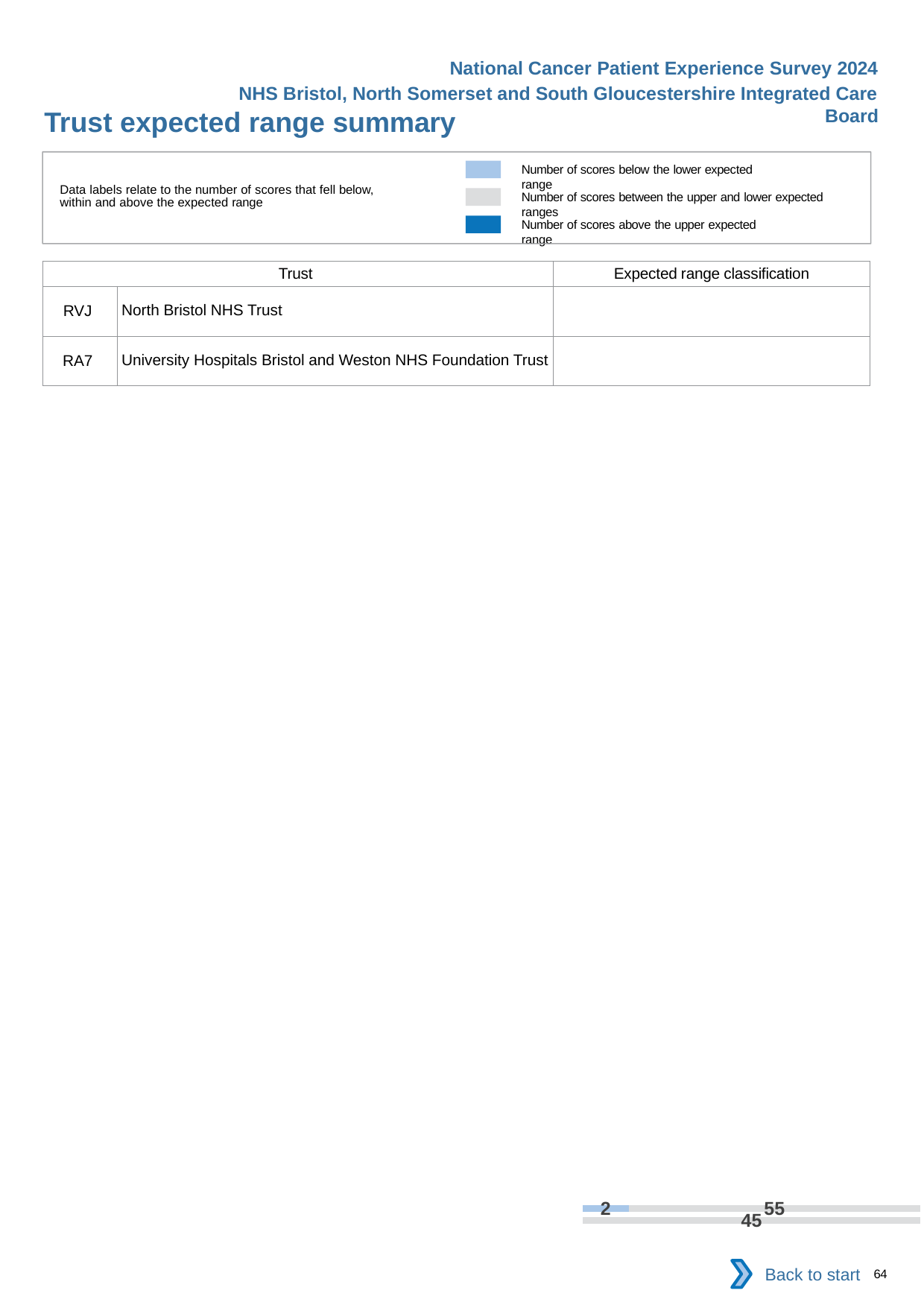
Which is larger: the grey segment of the upper bar or the grey segment of the lower bar? the grey segment of the upper bar What is the data label on the light blue segment of the upper bar? 2 What does the light blue colour in the legend represent? Number of scores below the lower expected range How many series does the legend list? 3 What is the title of the slide? Trust expected range summary What is the data label on the grey segment of the lower bar? 45 What is the data label on the grey segment of the upper bar? 55 What kind of chart is shown at the bottom of the slide? bar chart What is the difference between the grey segment of the upper bar (55) and the grey segment of the lower bar (45)? 10 How many trusts are listed in the table? 2